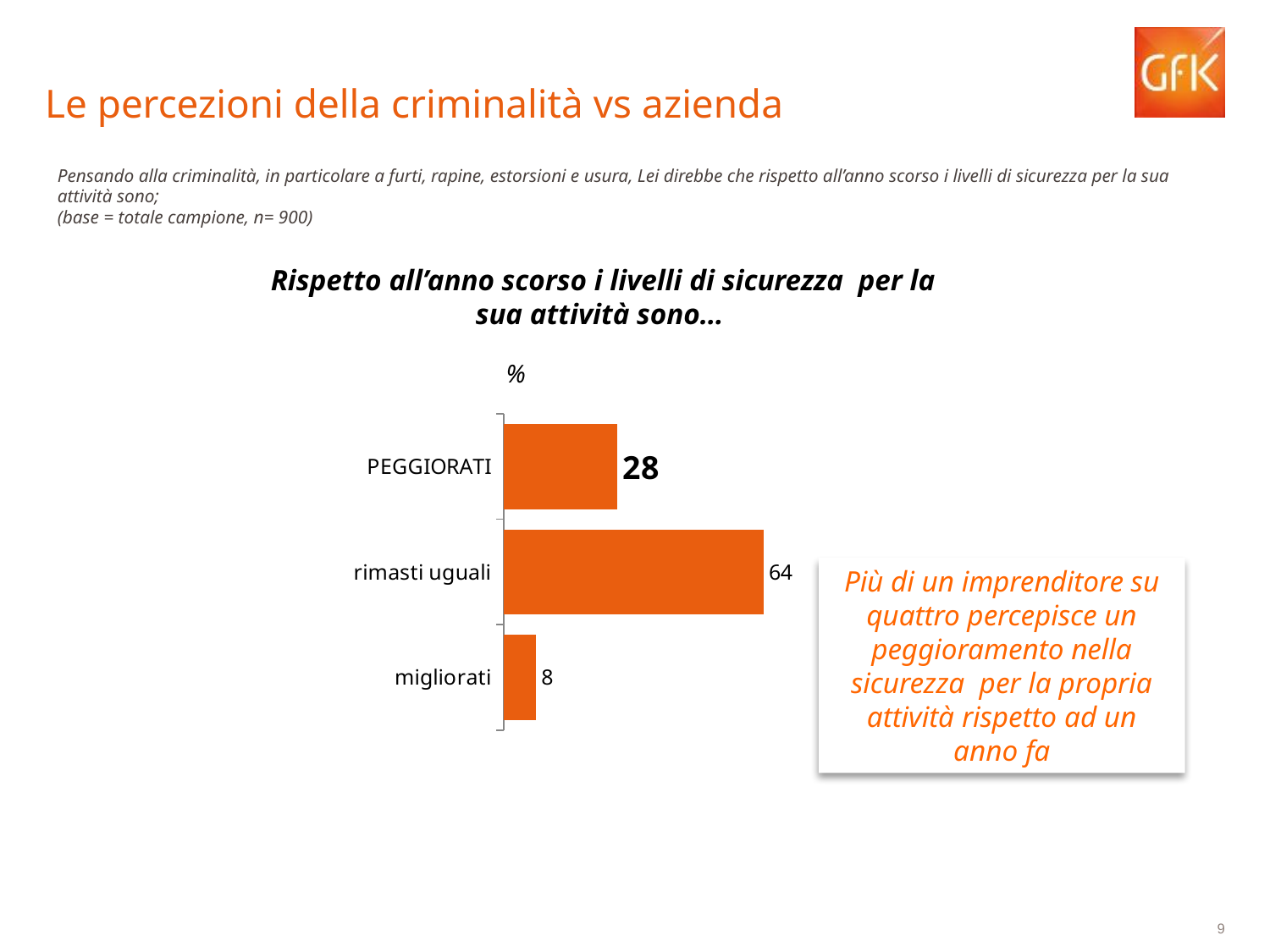
What is the value for rimasti uguali? 64 What is the value for PEGGIORATI? 28 Which category has the highest value? rimasti uguali What is the difference between the values for PEGGIORATI and migliorati? 20 What is the difference between the values for rimasti uguali and PEGGIORATI? 36 What is the title of the chart? Rispetto all'anno scorso i livelli di sicurezza per la sua attività sono… Which category has the lowest value? migliorati What kind of chart is shown on the slide? bar chart How many categories are shown in the chart? 3 What is the value for migliorati? 8 What colour are the bars in the chart? orange Which is larger, the value for PEGGIORATI or the value for migliorati? PEGGIORATI